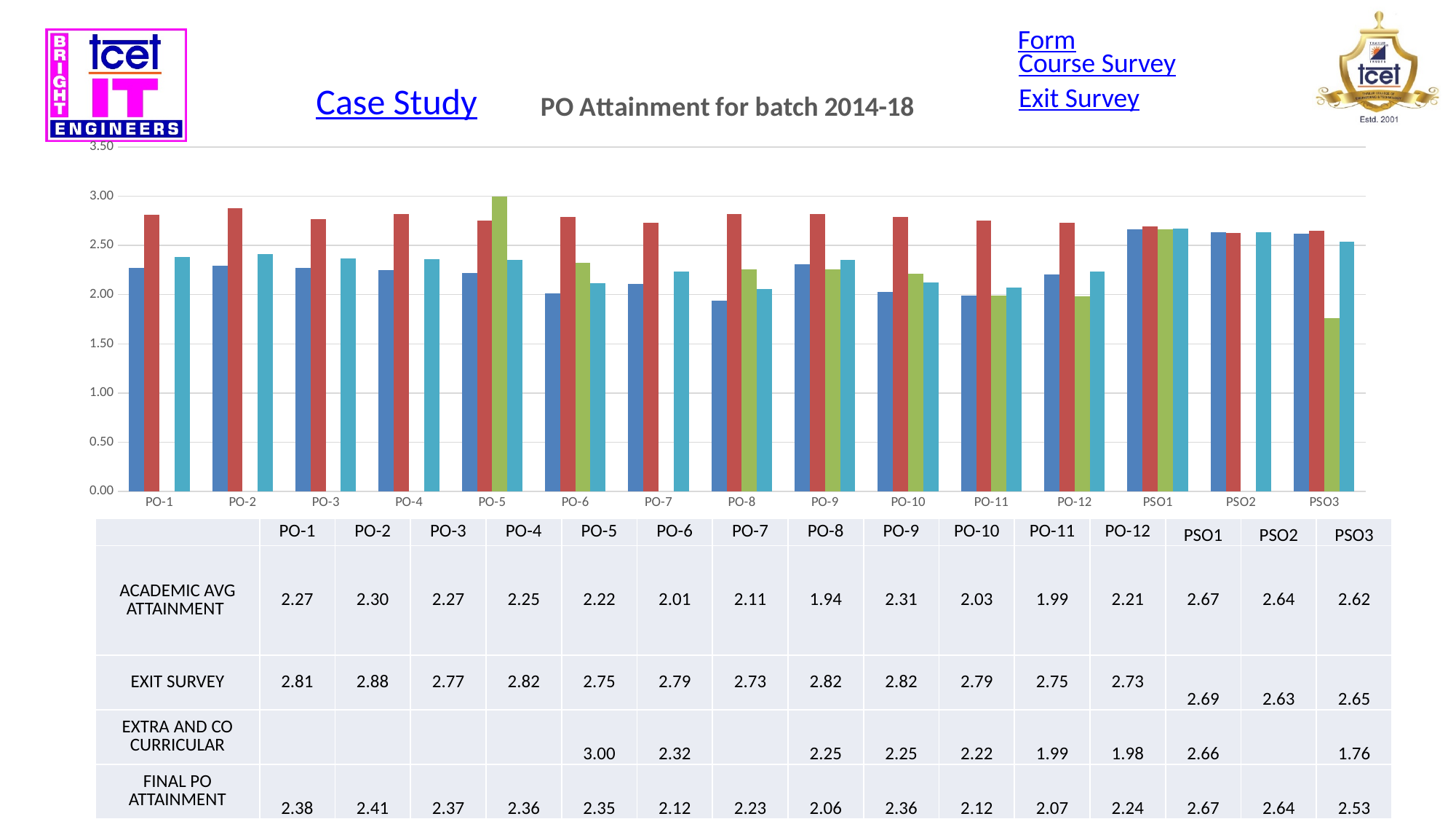
How many categories are shown on the x axis of the chart? 15 What is the Exit Survey value for PO-2? 2.88 Which category has the lowest Extra and Co Curricular value? PSO3 What is the Academic Avg Attainment value for PO-8? 1.94 What kind of chart is shown on the slide? bar chart Which is larger, the Final PO Attainment for PO-1 or for PO-6? PO-1 Which category has the lowest Academic Avg Attainment value? PO-8 Which category has the highest Extra and Co Curricular value? PO-5 What is the difference between the Exit Survey and Academic Avg Attainment values for PO-2? 0.58 Which category has the highest Exit Survey value? PO-2 What is the Final PO Attainment value for PSO3? 2.53 Is the Exit Survey value for PO-1 greater or less than 2.50? greater